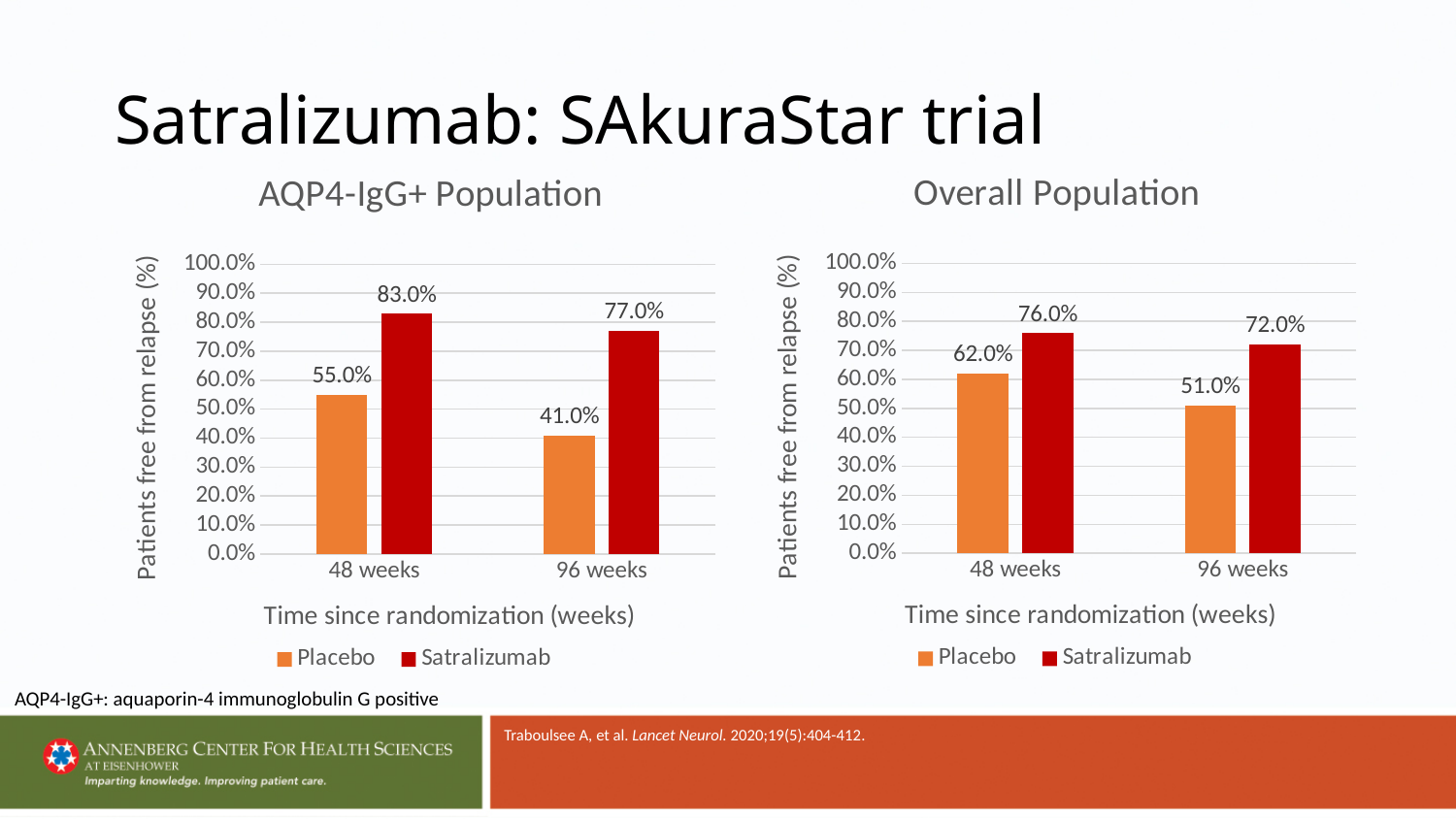
How many series does the legend of the Overall Population chart list? 2 In the Overall Population chart, what is the value for Satralizumab at 96 weeks? 72.0% In the AQP4-IgG+ Population chart, what is the difference between Satralizumab and Placebo at 48 weeks? 28.0% In the Overall Population chart, is the Placebo value at 96 weeks greater or less than 60.0%? less In the AQP4-IgG+ Population chart, does the Placebo value rise or fall from 48 weeks to 96 weeks? fall What kind of chart is the AQP4-IgG+ Population chart? bar chart In the Overall Population chart, what is the difference between Satralizumab and Placebo at 96 weeks? 21.0% In the Overall Population chart, what is the value for Placebo at 48 weeks? 62.0% In the AQP4-IgG+ Population chart, what is the value for Placebo at 96 weeks? 41.0% In the Overall Population chart, which bar is the highest? Satralizumab at 48 weeks In the AQP4-IgG+ Population chart, what is the value for Satralizumab at 48 weeks? 83.0% In the AQP4-IgG+ Population chart, which bar is the lowest? Placebo at 96 weeks